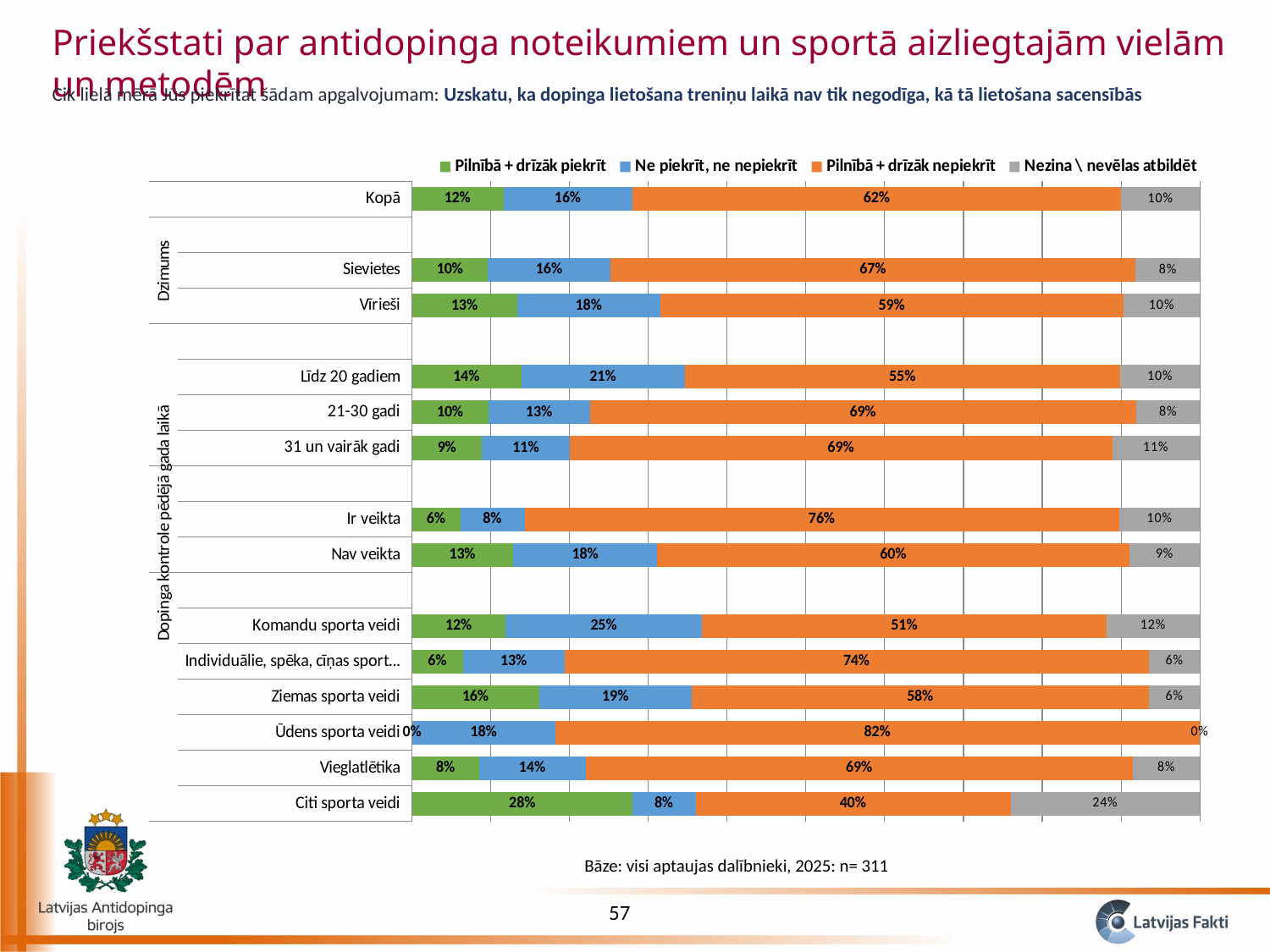
Which category has the lowest value for "Pilnībā + drīzāk nepiekrīt"? Citi sporta veidi What is the value of "Pilnībā + drīzāk nepiekrīt" for Kopā? 62% Which is larger: the "Ne piekrīt, ne nepiekrīt" value for Komandu sporta veidi or for Vieglatlētika? Komandu sporta veidi What is the value of "Pilnībā + drīzāk piekrīt" for Citi sporta veidi? 28% What is the difference between the "Pilnībā + drīzāk nepiekrīt" values for Sievietes and Vīrieši? 8% How many series does the legend list? 4 What is the value of "Pilnībā + drīzāk nepiekrīt" for Ir veikta? 76% What is the base (sample size) stated below the chart? n= 311 What is the value of "Ne piekrīt, ne nepiekrīt" for Līdz 20 gadiem? 21% What is the value of "Nezina \ nevēlas atbildēt" for Komandu sporta veidi? 12% Which category has the highest value for "Pilnībā + drīzāk nepiekrīt"? Ūdens sporta veidi What kind of chart is shown on the slide? Stacked bar chart